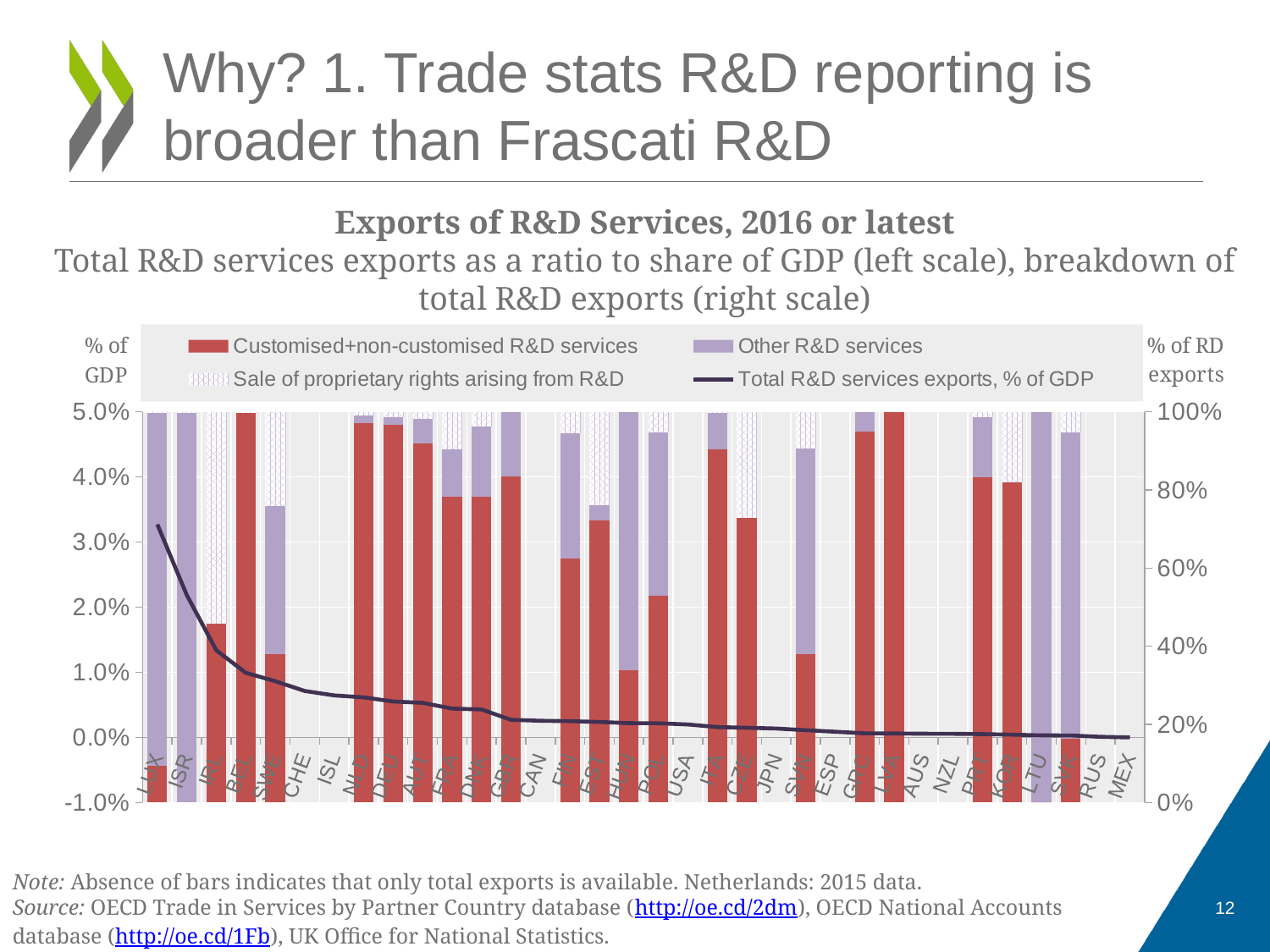
What kind of chart is shown on the slide? A combined bar and line chart (stacked bars with a line) Is the 'Total R&D services exports, % of GDP' value for LUX greater or less than 3.0%? greater Which legend entry is drawn as a line rather than a bar? Total R&D services exports, % of GDP Which country has the larger 'Customised+non-customised R&D services' bar, BEL or HUN? BEL Does the 'Total R&D services exports, % of GDP' line generally rise or fall from left to right across the countries? Fall How many countries are shown along the x axis of the chart? 34 Is the 'Total R&D services exports, % of GDP' value for IRL greater or less than 2.0%? less Is the 'Total R&D services exports, % of GDP' value for MEX greater or less than 1.0%? less How many series does the chart legend list? 4 Which country has the highest value on the 'Total R&D services exports, % of GDP' line? LUX What is the title of the chart? Exports of R&D Services, 2016 or latest